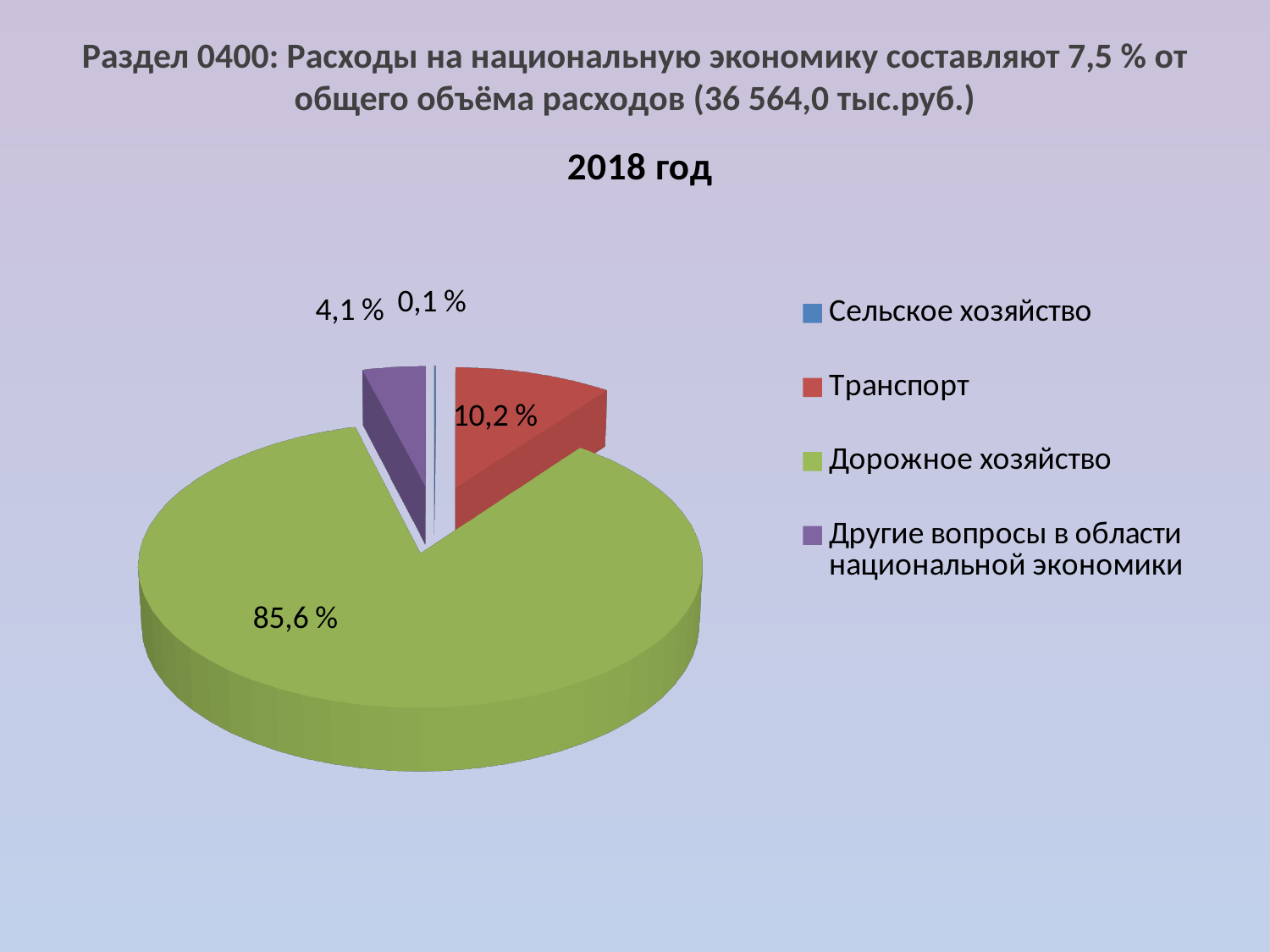
Which category has the smallest slice of the pie? Сельское хозяйство Which is larger, the share for Транспорт or the share for Другие вопросы в области национальной экономики? Транспорт What share of the pie does Транспорт have? 10,2 % What is the difference between the shares for Транспорт and Другие вопросы в области национальной экономики? 6,1 % What is the difference between the shares for Дорожное хозяйство and Транспорт? 75,4 % What is the title of the chart? 2018 год What kind of chart is shown on the slide? pie chart Which category has the largest slice of the pie? Дорожное хозяйство What share of the pie does Сельское хозяйство have? 0,1 % What share of the pie does Другие вопросы в области национальной экономики have? 4,1 % How many categories does the legend list? 4